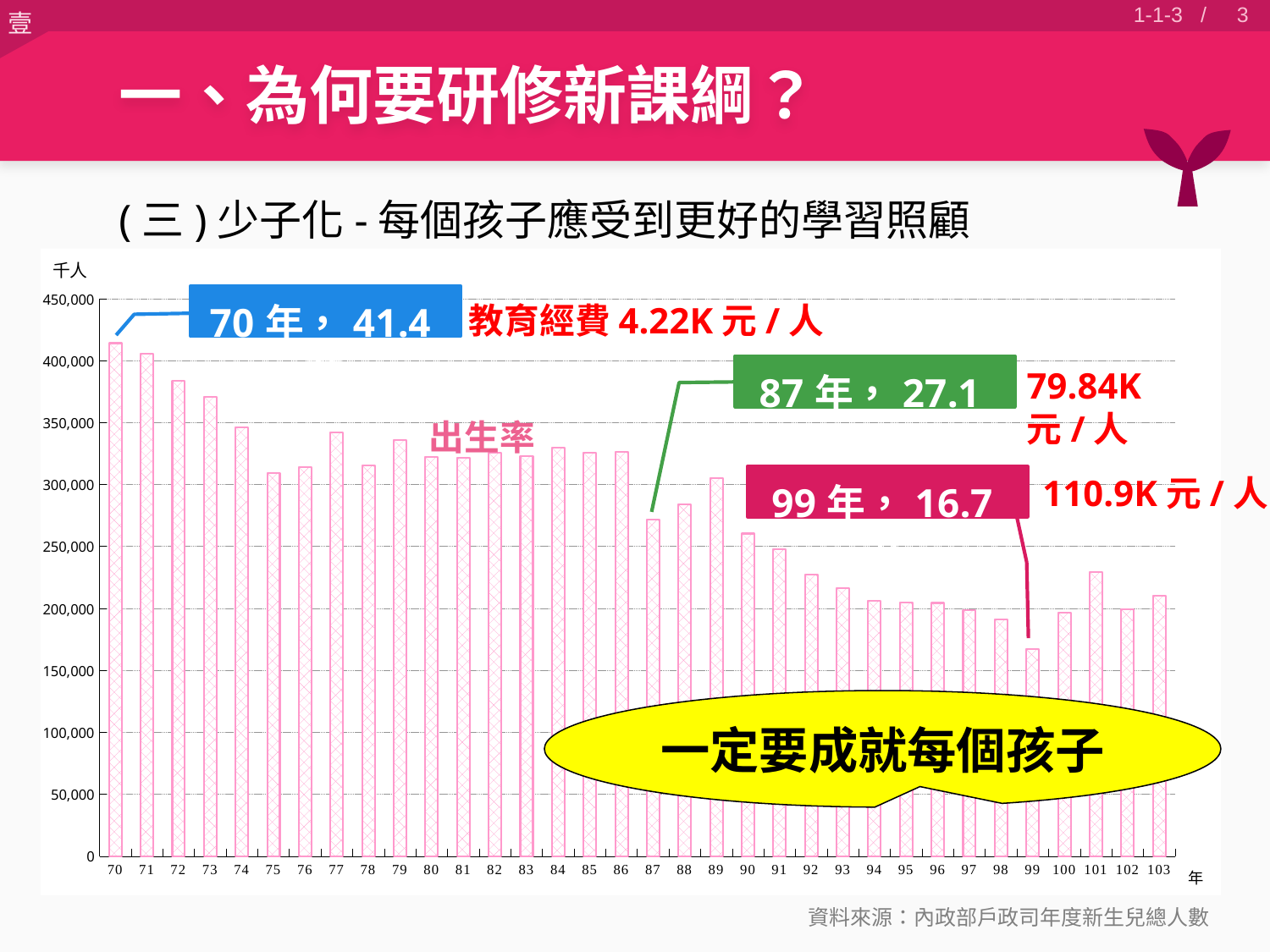
Is the value for year 72 greater or less than 400,000? less Do the bar values generally rise or fall from year 70 to year 103? fall What kind of chart is shown on the slide? bar chart What unit is shown at the top of the y axis? 千人 Is the value for year 99 greater or less than 200,000? less How many years (bars) are plotted on the x axis of the chart? 34 Which year has a larger value, 70 or 103? 70 Is the value for year 70 greater or less than 400,000? greater What birth rate value is shown in the callout for year 87? 27.1 Which year has the highest bar in the chart? 70 Which year has the lowest bar in the chart? 99